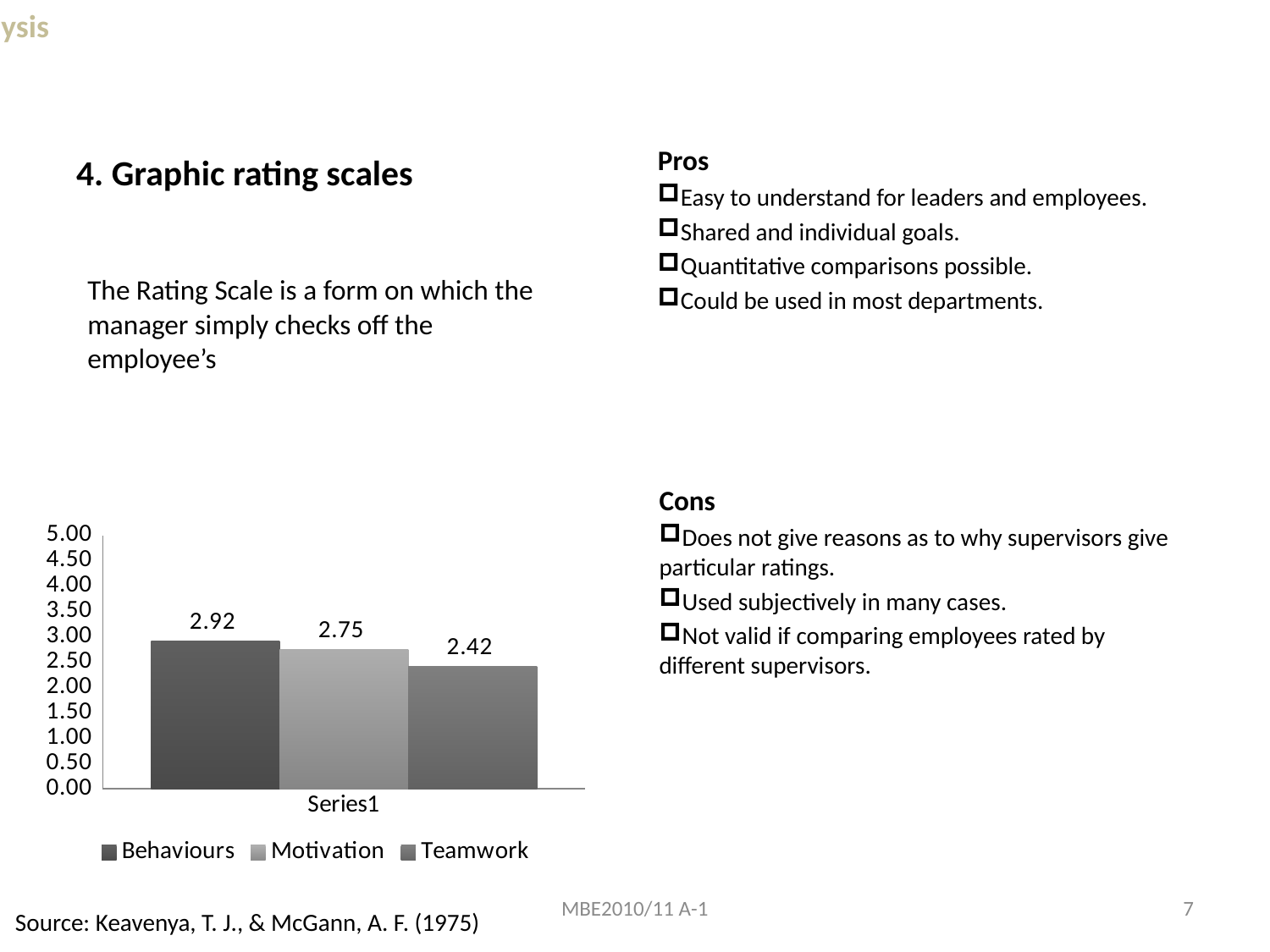
Which series has the lowest value? Teamwork What kind of chart is shown on the slide? bar chart How many series does the legend list? 3 Is the value for Teamwork greater or less than 2.50? less Which is larger, the value for Motivation or the value for Teamwork? Motivation What is the value for Motivation? 2.75 What is the difference between the values for Behaviours and Teamwork? 0.50 What is the category label shown on the x axis? Series1 What is the difference between the values for Behaviours and Motivation? 0.17 What is the value for Teamwork? 2.42 Which series has the highest value? Behaviours What is the value for Behaviours? 2.92